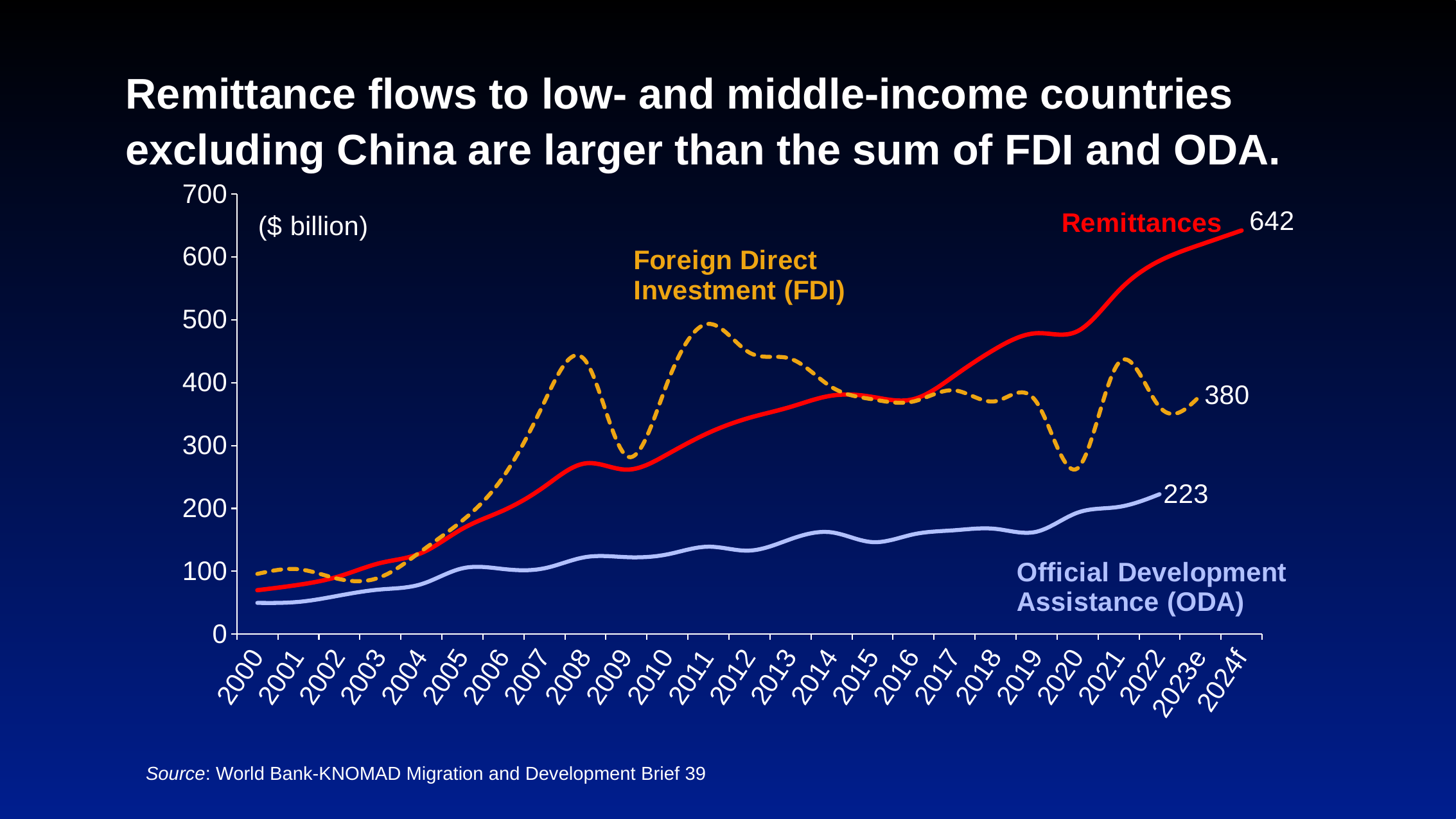
What is the labelled value of Official Development Assistance (ODA) at 2022? 223 Which series has the highest value at the right end of the chart (2024f)? Remittances What is the difference between the labelled end value of Remittances (642) and the labelled end value of ODA (223)? 419 Which series has the lowest value in 2000? Official Development Assistance (ODA) Is the value for Official Development Assistance (ODA) in 2010 greater or less than 200? less How many series are plotted on the chart? 3 Is the value for Remittances in 2020 greater or less than 400? greater What is the labelled value of Foreign Direct Investment (FDI) at 2023e? 380 In 2008, which is larger: Remittances or Foreign Direct Investment (FDI)? Foreign Direct Investment (FDI) What type of chart is shown on the slide? line chart How many years are shown on the x axis? 25 What is the labelled value of Remittances at 2024f? 642